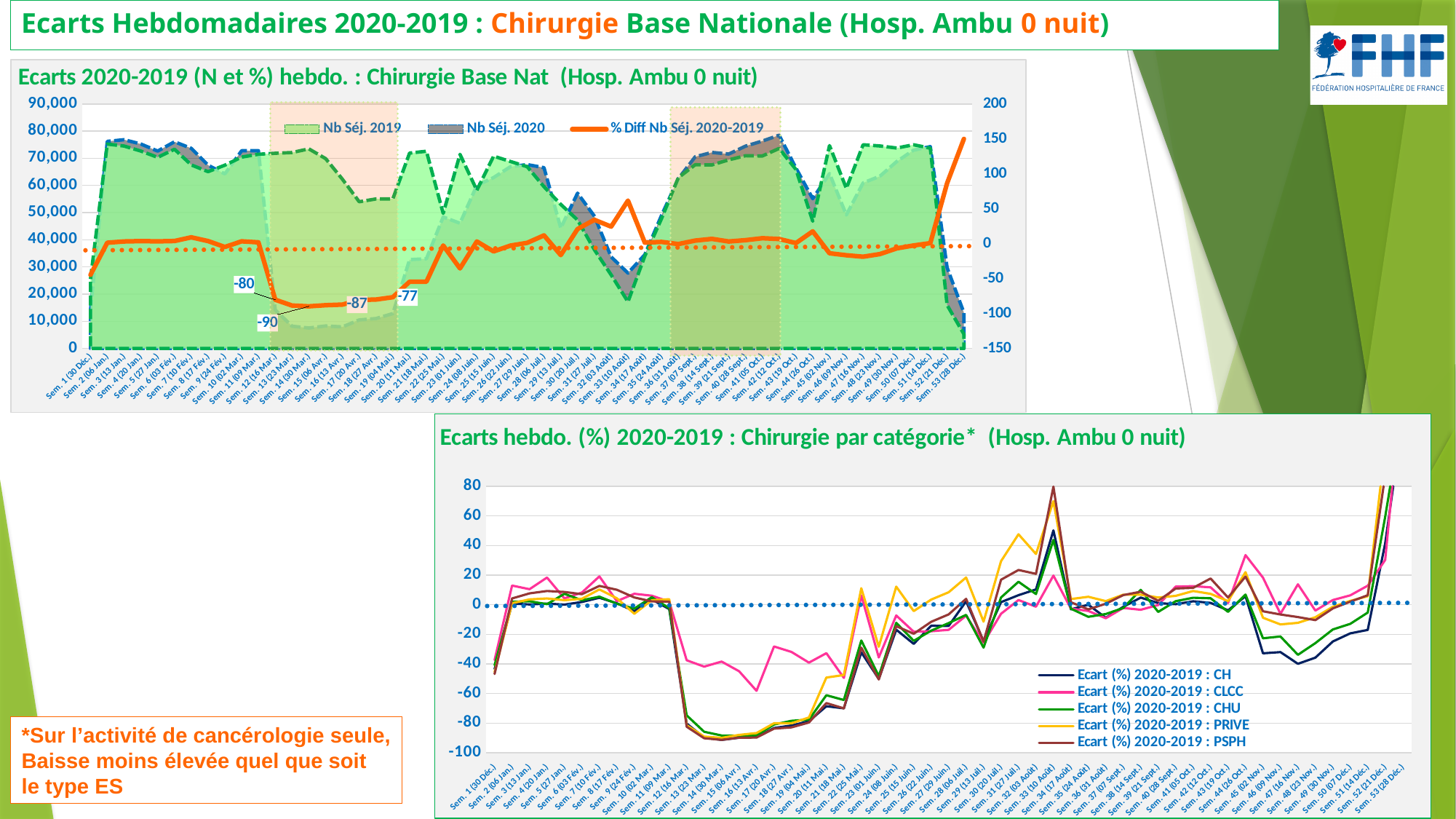
On the bottom chart 'Ecarts hebdo. (%) 2020-2019 : Chirurgie par catégorie*', how many series does the legend list? 5 On the top chart 'Ecarts 2020-2019 (N et %) hebdo.', does the '% Diff Nb Séj. 2020-2019' line rise or fall between Sem. 50 (07 Déc.) and Sem. 53 (28 Déc.)? rise On the top chart 'Ecarts 2020-2019 (N et %) hebdo.', how many series does the legend list? 3 On the top chart 'Ecarts 2020-2019 (N et %) hebdo.', what colour is the '% Diff Nb Séj. 2020-2019' line? orange On the bottom chart 'Ecarts hebdo. (%) 2020-2019 : Chirurgie par catégorie*', is the value for CLCC at Sem. 14 (30 Mar.) greater or less than -60? greater On the bottom chart 'Ecarts hebdo. (%) 2020-2019 : Chirurgie par catégorie*', which series has the highest value at Sem. 33 (10 Août)? Ecart (%) 2020-2019 : PSPH What kind of chart is the bottom chart 'Ecarts hebdo. (%) 2020-2019 : Chirurgie par catégorie*'? line chart On the bottom chart 'Ecarts hebdo. (%) 2020-2019 : Chirurgie par catégorie*', at Sem. 14 (30 Mar.), which is larger: the value for CLCC or the value for CH? CLCC On the bottom chart 'Ecarts hebdo. (%) 2020-2019 : Chirurgie par catégorie*', which series has the highest value at Sem. 47 (16 Nov.)? Ecart (%) 2020-2019 : CLCC On the top chart 'Ecarts 2020-2019 (N et %) hebdo.', what is the lowest value labelled on the '% Diff Nb Séj. 2020-2019' line? -90